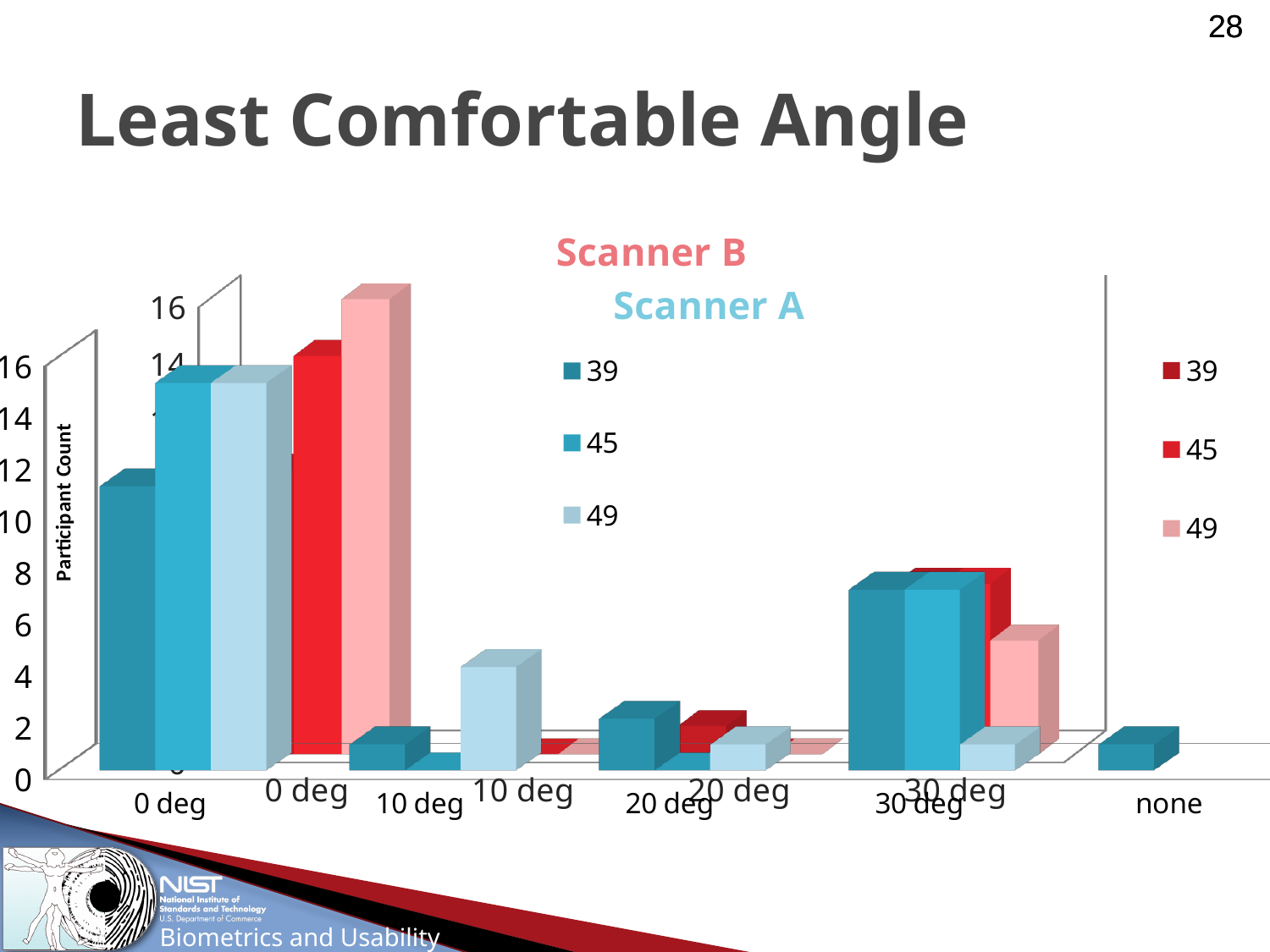
In the Scanner A chart, which category has the highest value for series 45? 0 deg In the Scanner B chart, is the value for series 49 at 30 deg greater or less than 10? less What is the vertical axis title of the Scanner A chart? Participant Count How many series does the Scanner A legend list? 3 How many categories are shown on the x axis of the Scanner A chart? 5 In the Scanner A chart, is the value for series 49 at 10 deg greater or less than 8? less What are the legend entries for the Scanner B chart? 39, 45, 49 In the Scanner B chart, is the value for series 49 at 0 deg greater or less than 10? greater In the Scanner A chart, which is larger for series 39: the value at 0 deg or the value at 30 deg? 0 deg In the Scanner A chart, which is larger for series 49: the value at 10 deg or the value at 20 deg? 10 deg What kind of chart is used for Scanner A on the slide? bar chart